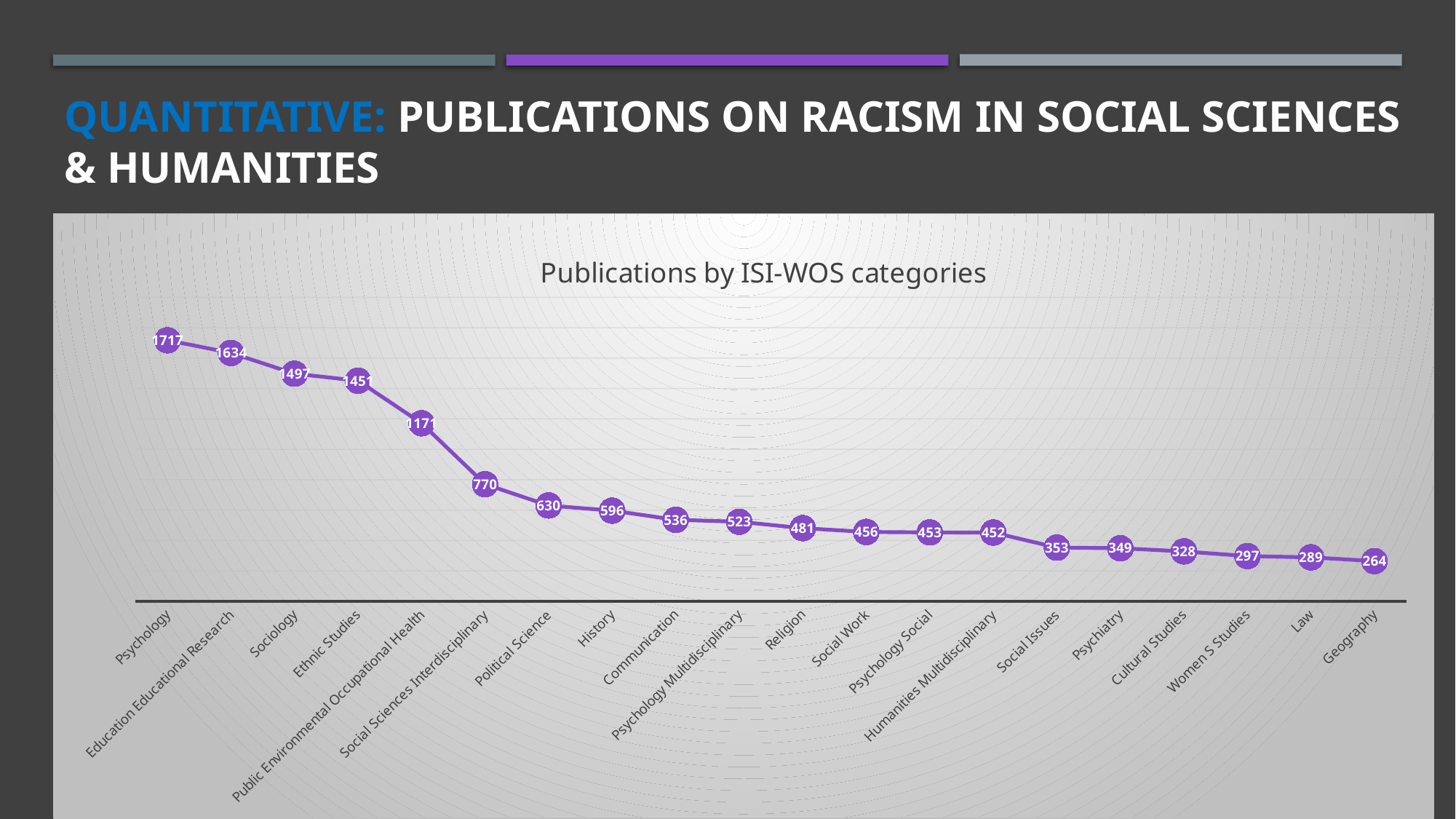
Which category has the lowest number of publications? Geography What is the value for Geography? 264 Which category has the highest number of publications? Psychology What kind of chart is shown on the slide? line chart How many categories are plotted on the chart? 20 What is the title of the chart? Publications by ISI-WOS categories What is the value for Social Sciences Interdisciplinary? 770 Which has more publications, Political Science or History? Political Science How many publications are shown for Psychology? 1717 What is the difference between the values for Psychology and Education Educational Research? 83 What is the value for Religion? 481 What is the difference between the values for Ethnic Studies and Public Environmental Occupational Health? 280